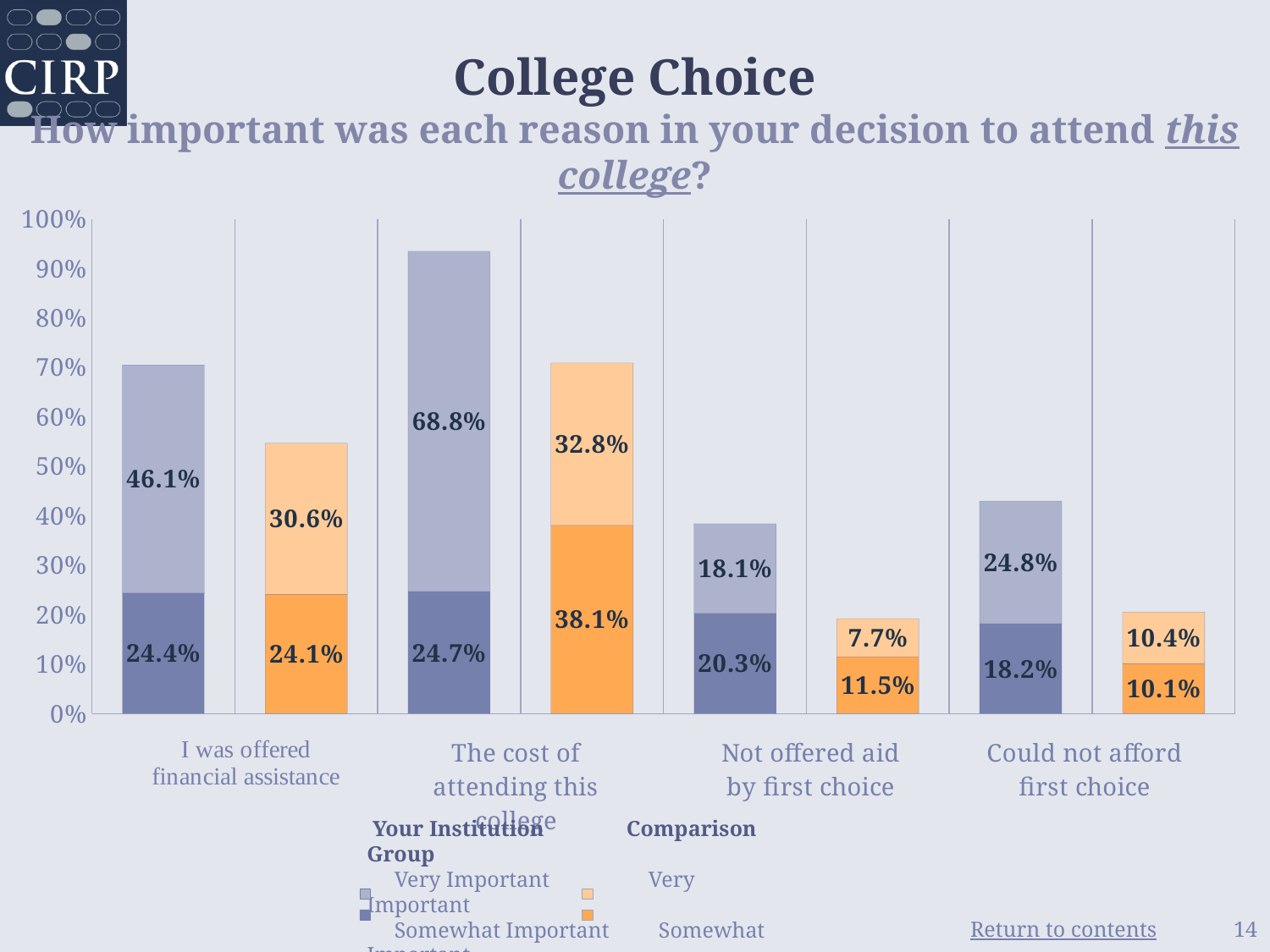
What percentage of the Comparison Group rated "I was offered financial assistance" as Somewhat Important? 24.1% What is the total stacked value for the Comparison Group on "Could not afford first choice"? 20.5% What is the Comparison Group's Very Important value for "Not offered aid by first choice"? 7.7% For "The cost of attending this college", which is larger: the Comparison Group's Very Important value or its Somewhat Important value? Somewhat Important Which colour represents the Comparison Group bars? Orange Which reason has the highest Very Important percentage for Your Institution? The cost of attending this college Which reason has the lowest Very Important percentage for the Comparison Group? Not offered aid by first choice What kind of chart is shown on the slide? Stacked bar chart How many reasons (categories) are shown on the x axis? 4 What percentage of Your Institution respondents rated "The cost of attending this college" as Very Important? 68.8% What is the difference between Your Institution's and the Comparison Group's Very Important values for "I was offered financial assistance"? 15.5% What is the total stacked value (Very Important plus Somewhat Important) for Your Institution on "Not offered aid by first choice"? 38.4%